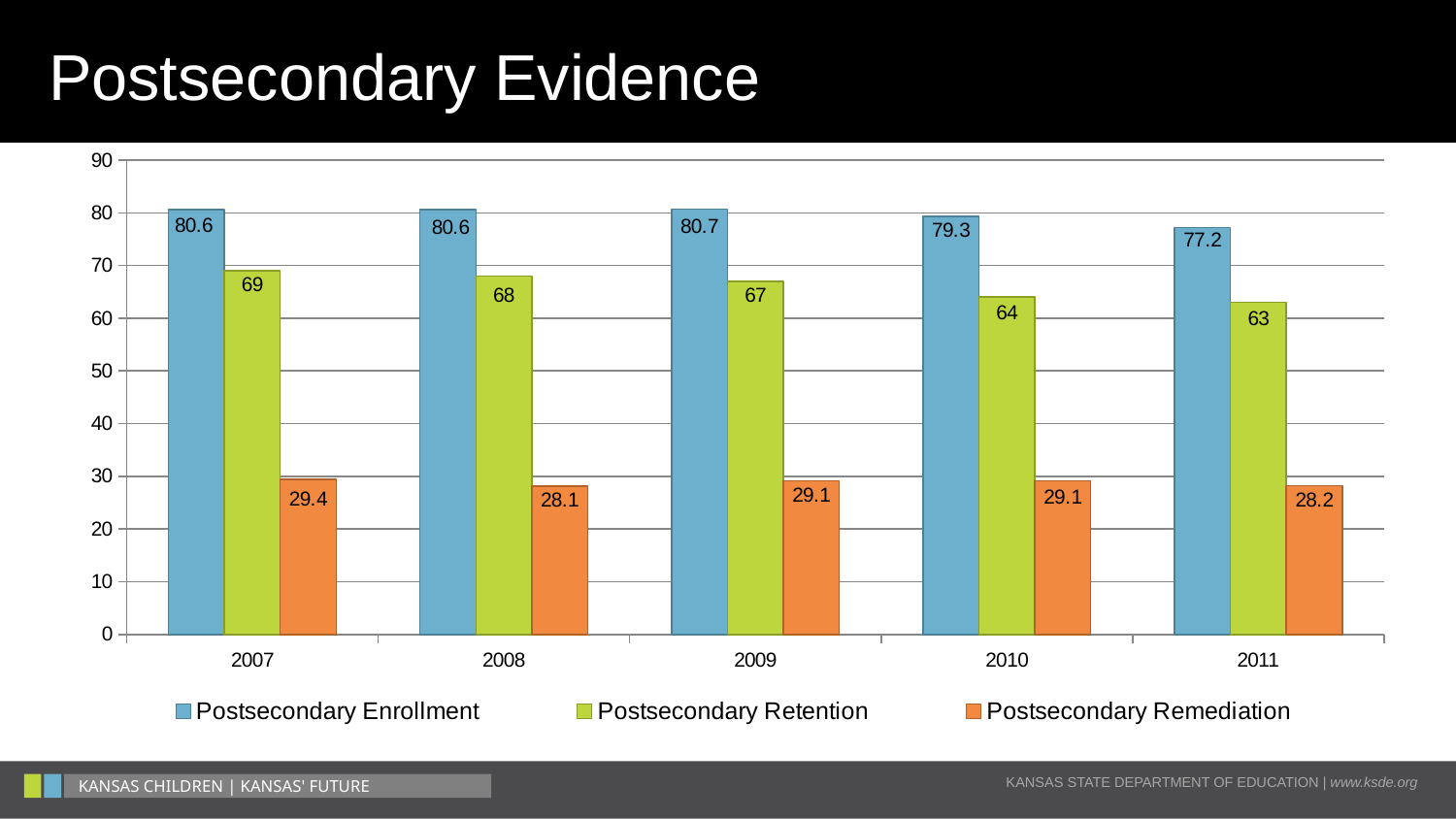
What is the Postsecondary Remediation value for 2007? 29.4 Is the Postsecondary Remediation value for 2008 larger or smaller than the value for 2007? smaller What is the Postsecondary Retention value for 2010? 64 How many series does the legend list? 3 Which year has the highest Postsecondary Retention value? 2007 How many years are shown on the x axis? 5 Does the Postsecondary Retention series rise or fall from 2007 to 2011? fall What is the Postsecondary Enrollment value for 2009? 80.7 What kind of chart is shown on the slide? bar chart What is the title of the slide containing the chart? Postsecondary Evidence Which year has the lowest Postsecondary Enrollment value? 2011 What is the difference between Postsecondary Enrollment and Postsecondary Retention in 2011? 14.2